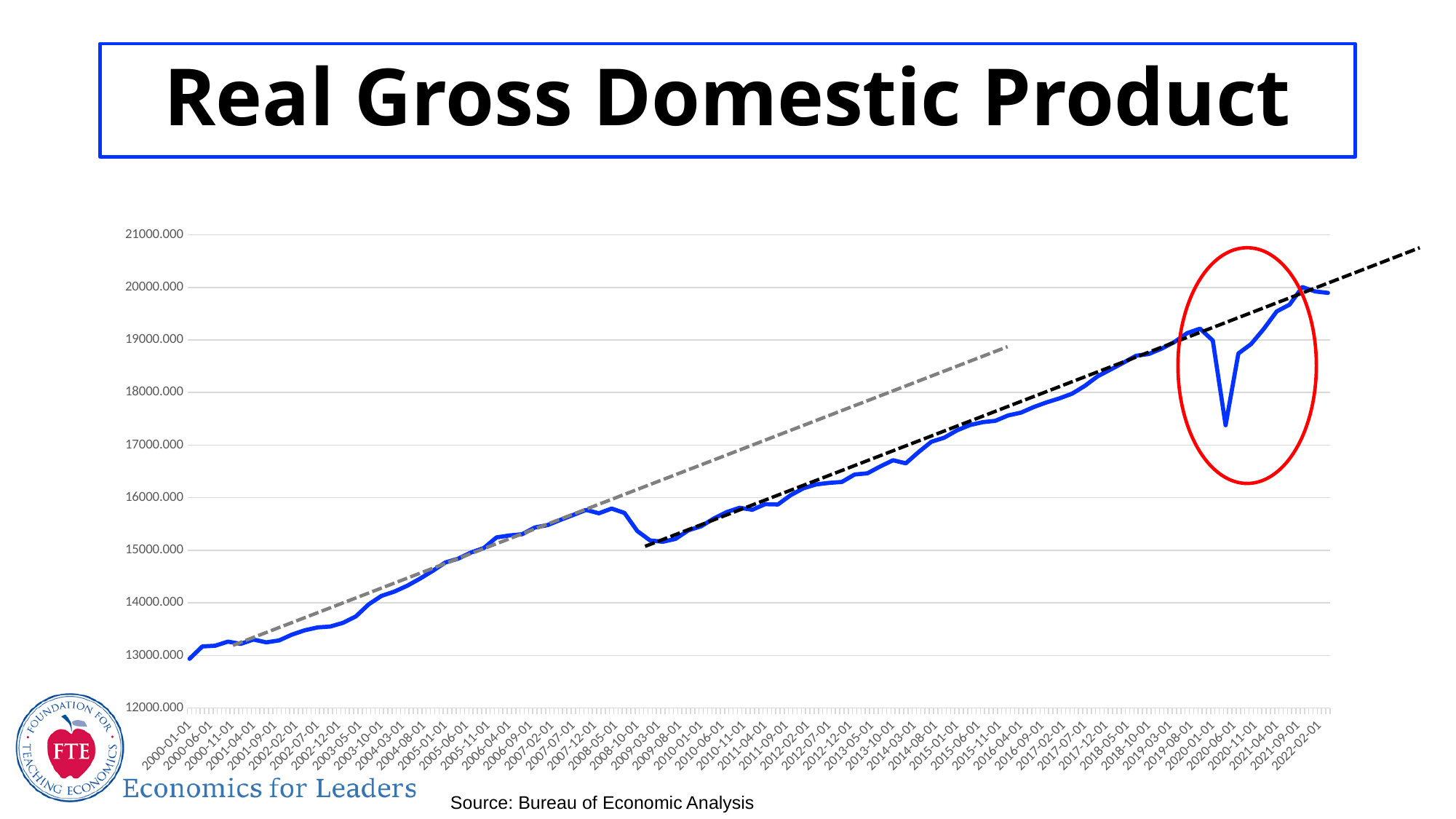
At which date on the x axis is the Real GDP line at its lowest? 2000-01-01 Is the value at 2000-01-01 greater or less than 14000.000? less Is the value at 2020-06-01 greater or less than 17000.000? greater What source is cited for the chart data? Bureau of Economic Analysis Is the value at 2018-05-01 greater or less than 18000.000? greater Is the value at 2010-01-01 larger or smaller than the value at 2016-04-01? smaller What kind of chart is shown on the slide? line chart Overall, does the Real GDP line rise or fall from 2000-01-01 to 2022-02-01? rise What is the title of the slide? Real Gross Domestic Product